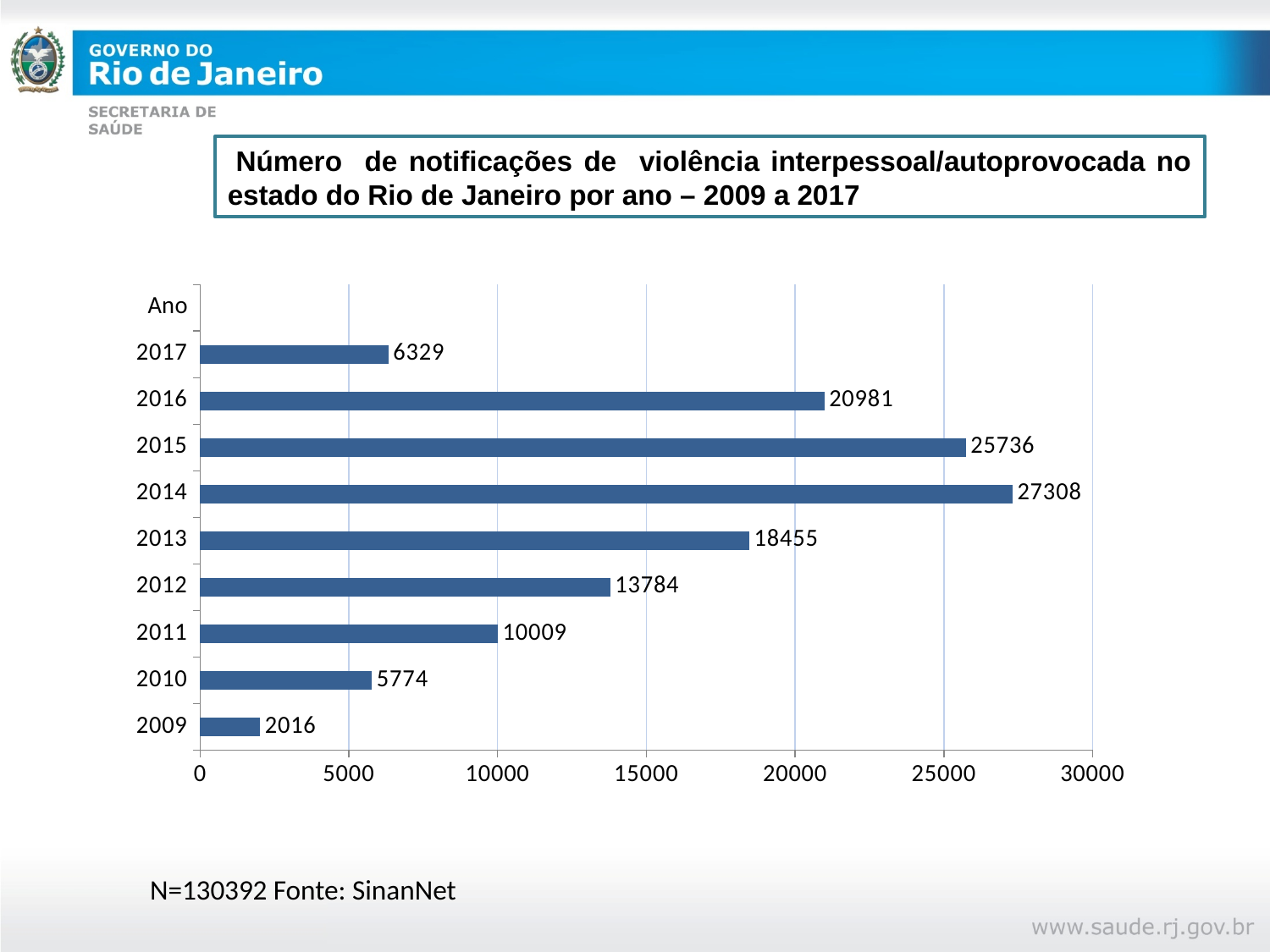
What kind of chart is shown on the slide? bar chart What is the difference between the values for 2015 and 2016? 4755 What is the difference between the values for 2013 and 2012? 4671 What is the number of notifications for 2009? 2016 What is the value shown for 2012? 13784 Which year has the highest number of notifications? 2014 What is the source cited below the chart? SinanNet Is the value for 2011 greater or less than 15000? less Which is larger, the value for 2017 or the value for 2010? 2017 Which year has the lowest number of notifications? 2009 What is the number of notifications for 2014? 27308 How many years are shown in the chart? 9